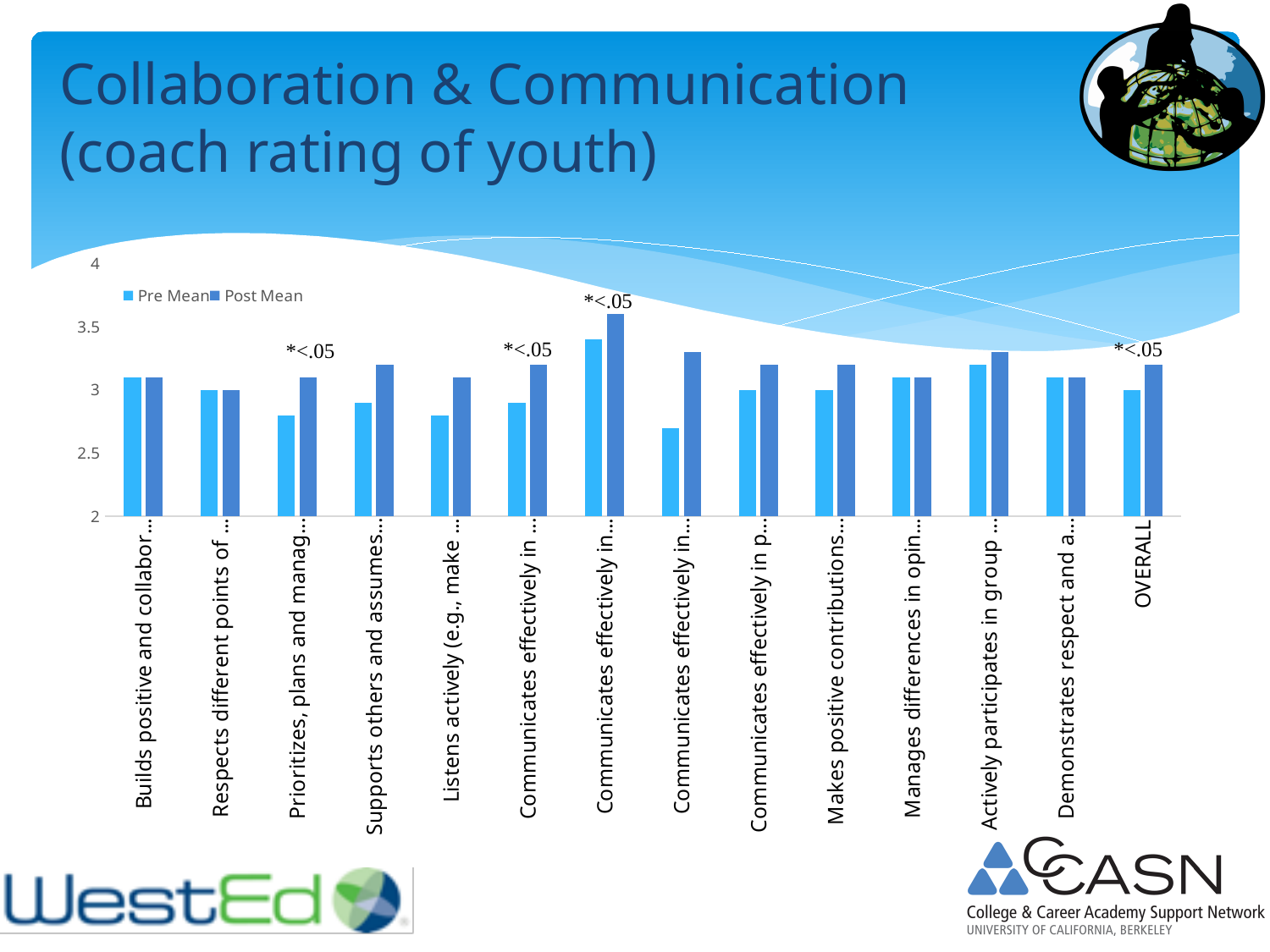
Is the Post Mean value for the category 'Supports others and assumes...' greater or less than 3? greater How many series does the chart legend list? 2 For the OVERALL category, which series has the larger value, Pre Mean or Post Mean? Post Mean Is the Post Mean value for OVERALL greater or less than 3? greater Which series has the lowest bar anywhere in the chart, Pre Mean or Post Mean? Pre Mean What kind of chart is shown on the slide? bar chart What are the two series named in the chart legend? Pre Mean and Post Mean How many categories in the chart are annotated with '*<.05'? 4 What is the Pre Mean value for the OVERALL category? 3 How many categories are plotted along the x axis of the chart? 14 Is the Pre Mean value for the category 'Prioritizes, plans and manag...' greater or less than 3? less What is the Pre Mean value for the category 'Makes positive contributions...'? 3